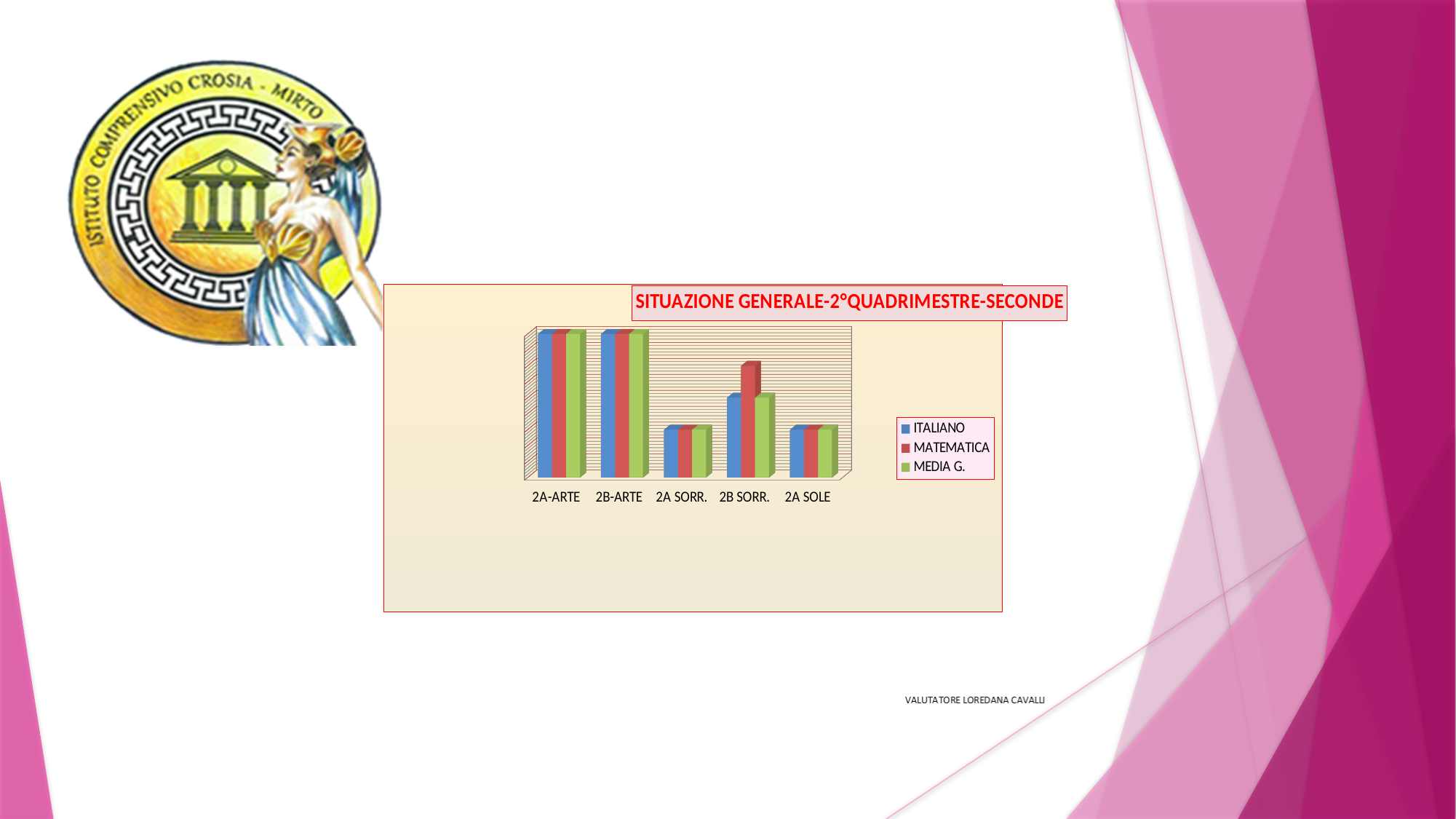
How many series does the chart's legend list? 3 How many categories are shown on the x axis of the chart? 5 Which category label appears first on the x axis of the chart? 2A-ARTE For the category 2B SORR., which series has the highest bar? MATEMATICA Is the MEDIA G. value for 2A-ARTE larger or smaller than the MEDIA G. value for 2A SOLE? larger For 2B SORR., is the MATEMATICA bar taller or shorter than the ITALIANO bar? taller What kind of chart is shown on the slide? bar chart Is the MATEMATICA value for 2A SORR. larger or smaller than the MATEMATICA value for 2B-ARTE? smaller What is the title of the chart? SITUAZIONE GENERALE-2°QUADRIMESTRE-SECONDE Which series is shown in red in the chart? MATEMATICA